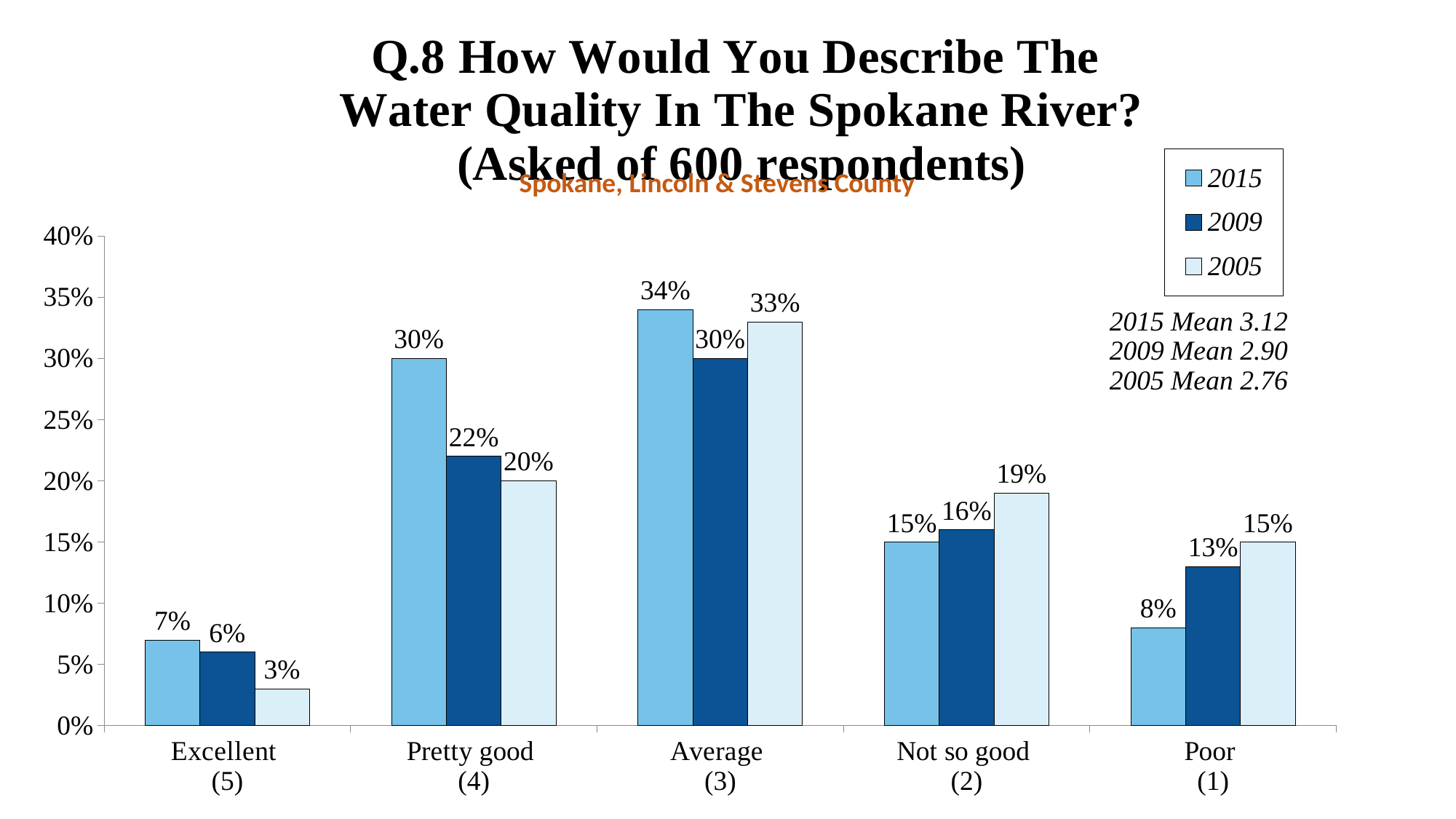
What is the 2015 mean shown on the slide? 3.12 What percentage of respondents described the water quality as Average in 2015? 34% What percentage of respondents described the water quality as Poor in 2009? 13% Which category has the lowest value for the 2005 series? Excellent (5) What percentage of respondents described the water quality as Excellent in 2005? 3% Which year does the darkest blue series in the legend represent? 2009 What kind of chart is shown on the slide? Bar chart How many series does the legend list? 3 Which is larger for Not so good: the 2015 value or the 2005 value? 2005 Which category has the highest value for the 2015 series? Average (3) What is the difference between the 2015 and 2005 values for Pretty good? 10% How many response categories are shown on the x axis? 5